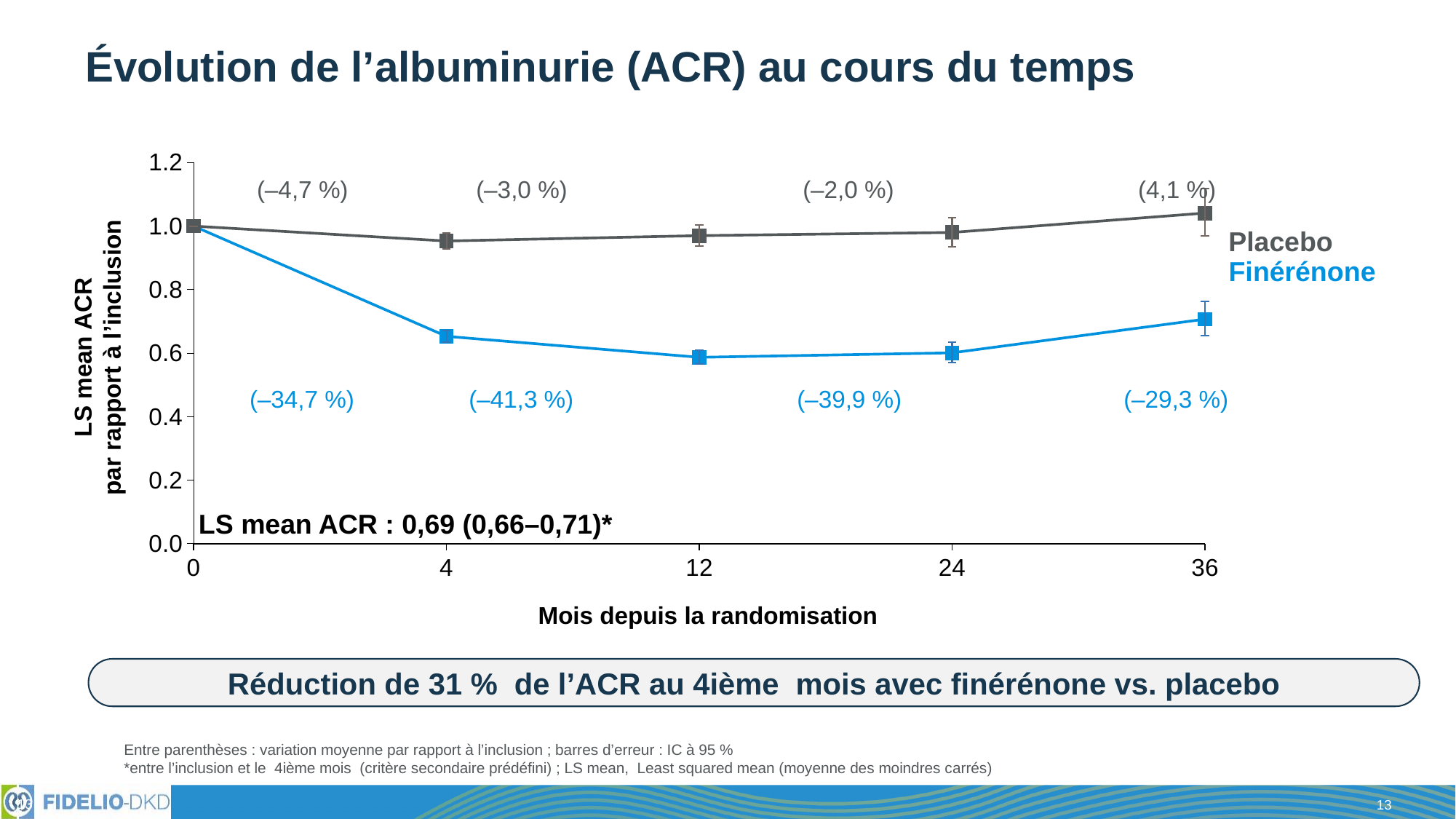
What mean change from baseline is printed for Placebo at month 36? 4,1 % What mean change from baseline is printed for Finérénone at month 12? –41,3 % What mean change from baseline is printed for Finérénone at month 4? –34,7 % How many series does the chart show? 2 What kind of chart is shown on the slide? line chart Does the Finérénone line rise or fall between month 0 and month 4? fall Is the Finérénone value at month 12 greater or less than 0.8? less How many time points are plotted along the x axis? 5 Is the Placebo value at month 24 greater or less than 0.8? greater What mean change from baseline is printed for Placebo at month 4? –4,7 % At month 36, which series has the higher LS mean ACR value, Placebo or Finérénone? Placebo What is the label of the x axis? Mois depuis la randomisation